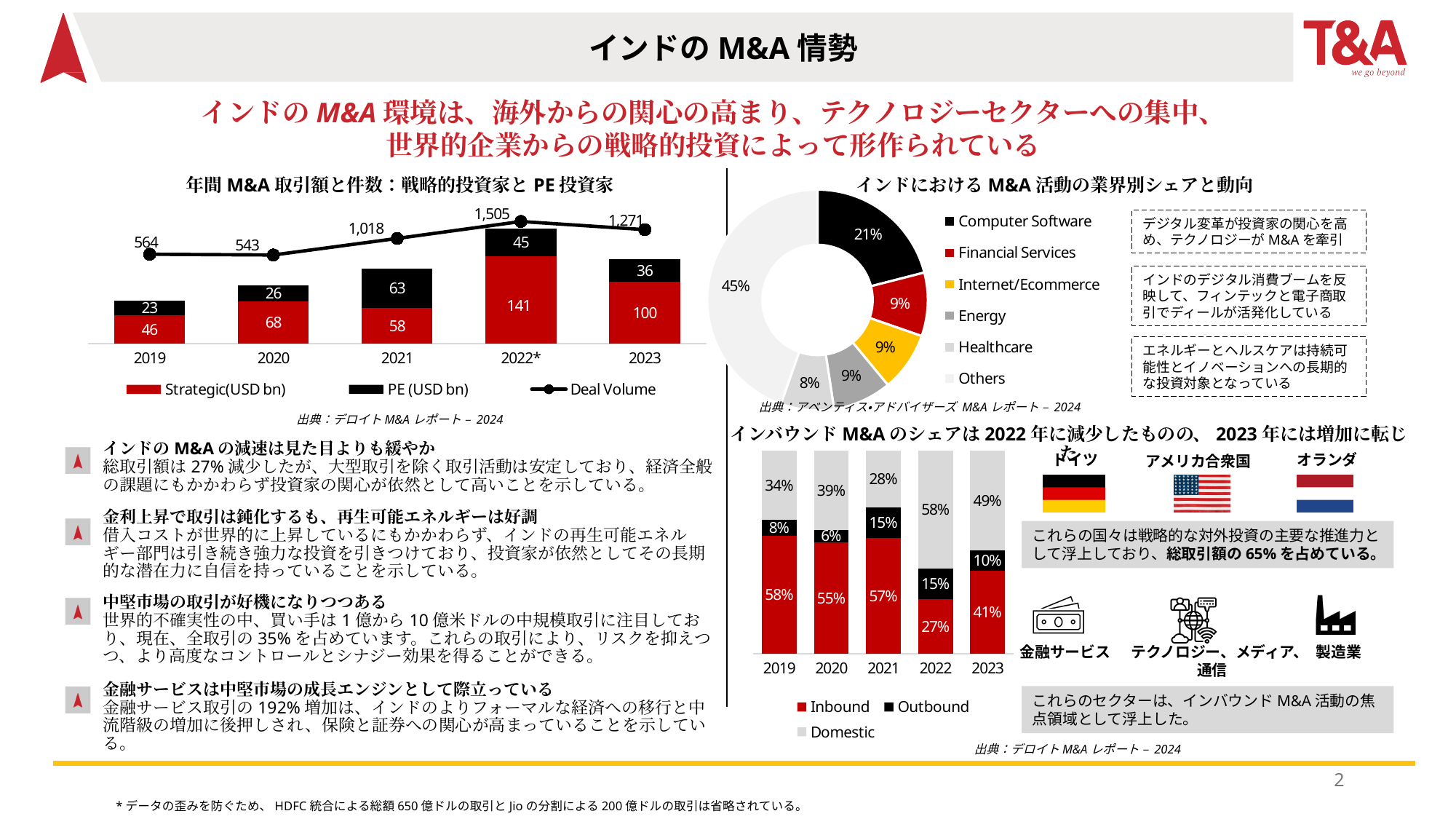
In the chart titled インドにおける M&A 活動の業界別シェアと動向, which category has the largest share? Others In the chart titled インドにおける M&A 活動の業界別シェアと動向, how many categories does the legend list? 6 In the chart titled 年間 M&A 取引額と件数：戦略的投資家と PE 投資家, what is the Strategic (USD bn) value for 2022*? 141 In the chart titled 年間 M&A 取引額と件数：戦略的投資家と PE 投資家, which year has the highest Deal Volume? 2022* In the stacked bar chart at the bottom right (Inbound/Outbound/Domestic), what is the Inbound share for 2022? 27% In the chart titled 年間 M&A 取引額と件数：戦略的投資家と PE 投資家, which is larger, the PE (USD bn) value for 2021 or for 2023? 2021 In the chart titled 年間 M&A 取引額と件数：戦略的投資家と PE 投資家, what is the Deal Volume for 2021? 1,018 In the stacked bar chart at the bottom right (Inbound/Outbound/Domestic), which year has the lowest Inbound share? 2022 In the chart titled 年間 M&A 取引額と件数：戦略的投資家と PE 投資家, what is the difference between the Strategic (USD bn) values for 2022* and 2023? 41 In the chart titled インドにおける M&A 活動の業界別シェアと動向, what share does Computer Software have? 21% What kind of chart is the chart titled インドにおける M&A 活動の業界別シェアと動向? Donut (pie) chart In the chart titled 年間 M&A 取引額と件数：戦略的投資家と PE 投資家, how many series does the legend list? 3